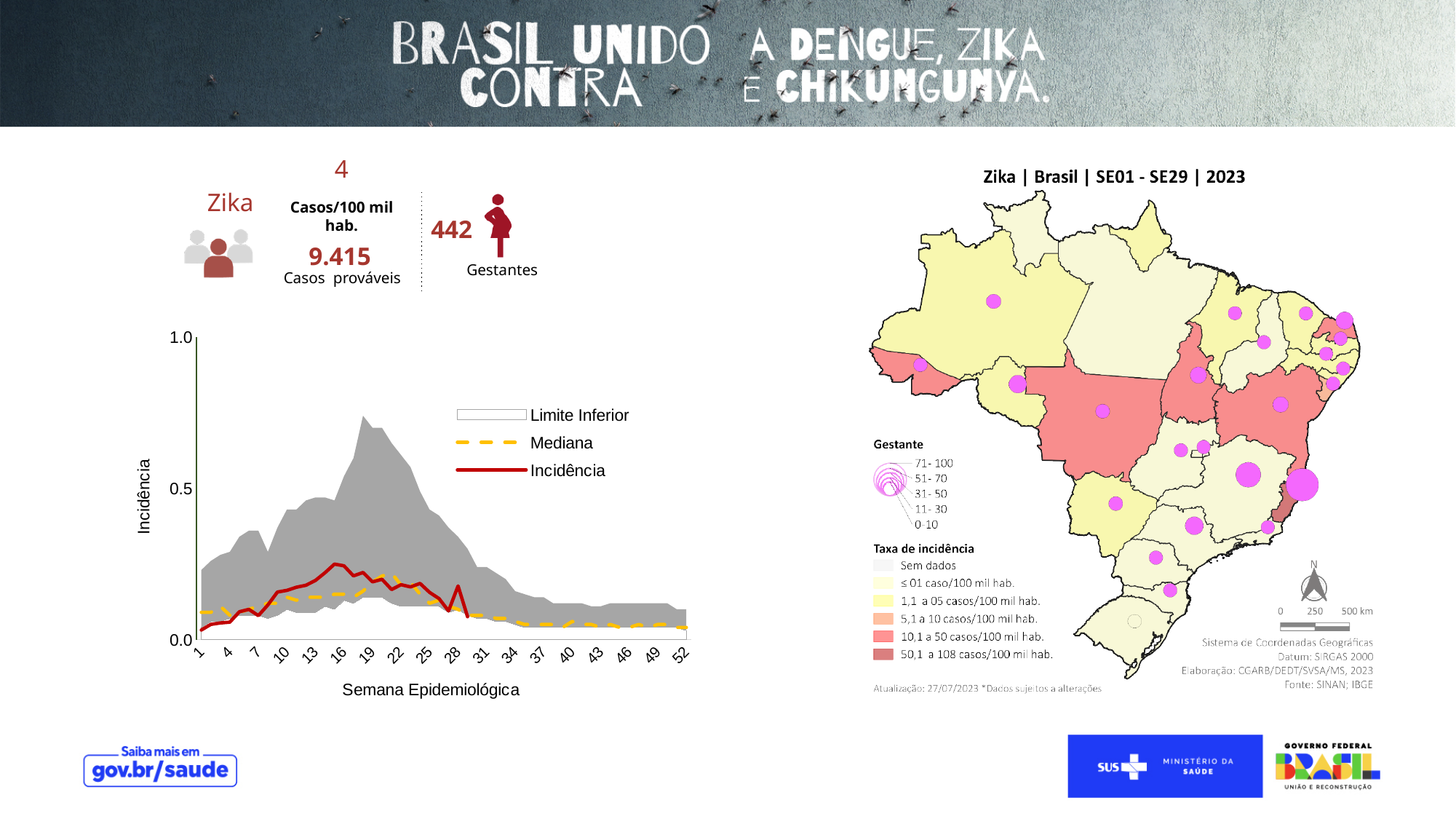
In the line chart, does the Incidência line rise or fall between week 16 and week 29? fall In the line chart, is the upper edge of the Limite Inferior shaded area at week 19 greater or less than 0.5? greater What is the label of the x axis of the line chart? Semana Epidemiológica What is the highest value shown on the y axis of the line chart? 1.0 What is the label of the y axis of the line chart? Incidência In the line chart, which is larger at week 19: the Incidência value or the upper edge of the Limite Inferior shaded area? Limite Inferior In the line chart, is the Incidência value at week 16 greater or less than 0.5? less In the line chart, is the Mediana value at week 52 greater or less than 0.5? less How many series does the legend of the line chart list? 3 What kind of chart is the chart on the left of the slide? combination area and line chart How many tick labels are shown on the x axis of the line chart? 18 In the line chart, does the Incidência line rise or fall between week 1 and week 16? rise